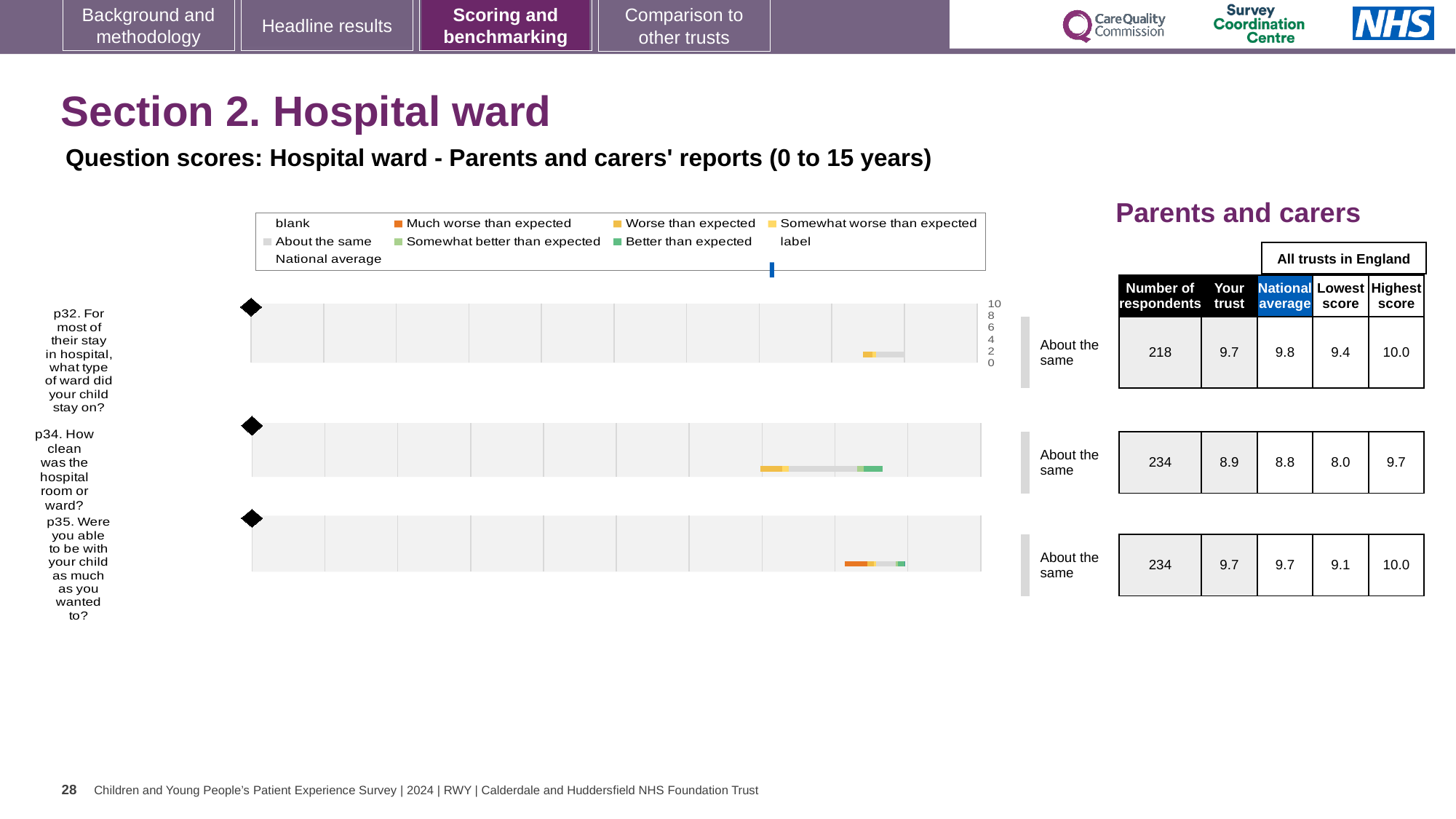
How many respondents are shown for question p32 (For most of their stay in hospital, what type of ward did your child stay on?)? 218 What is the highest score across all trusts in England for question p32? 10.0 Which of the three questions has the lowest 'Your trust' score? p34 What is the national average score for question p35 (Were you able to be with your child as much as you wanted to?)? 9.7 How many questions are plotted on this slide? 3 What kind of chart is used to show each question's score? Bar chart What is the lowest score across all trusts in England for question p34? 8.0 What is the difference between the 'Your trust' score and the national average for question p34? 0.1 What is the difference between the highest and lowest scores across all trusts in England for question p35? 0.9 What is the 'Your trust' score for question p34 (How clean was the hospital room or ward?)? 8.9 What benchmark category is shown for question p35? About the same Is the 'Your trust' score higher for question p32 or question p34? p32